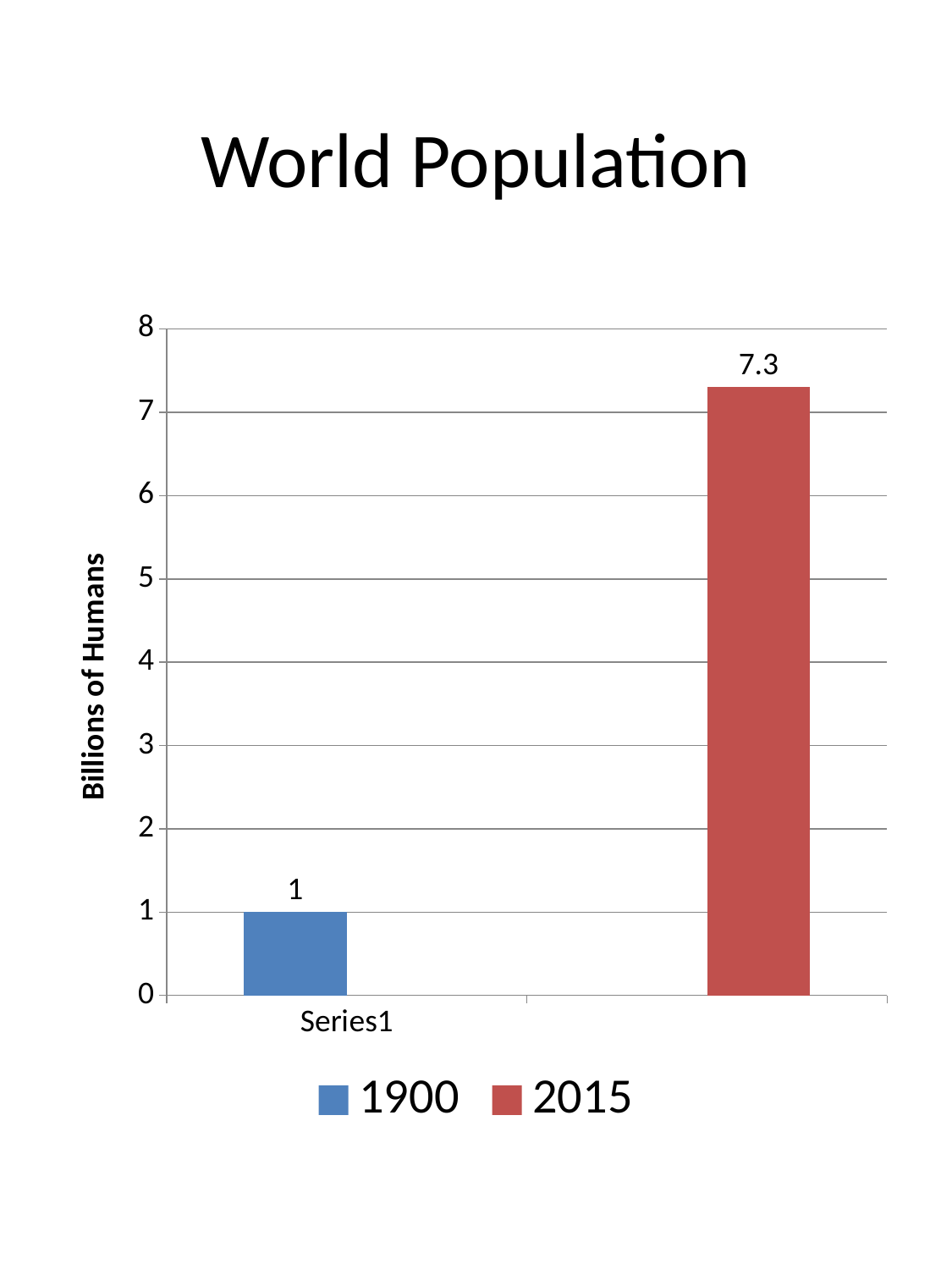
What kind of chart is shown on the slide? bar chart Which series has the lowest value in the World Population chart? 1900 What is the value for 2015 in the World Population chart? 7.3 What is the value for 1900 in the World Population chart? 1 Which series has the highest value in the World Population chart? 2015 Is the value for 2015 greater or less than 7? greater What is the title of the chart? World Population What is the difference between the 2015 and 1900 values in the World Population chart? 6.3 What is the label on the vertical axis of the chart? Billions of Humans Which is larger in the World Population chart, the value for 1900 or the value for 2015? 2015 How many series does the legend list in the World Population chart? 2 What is the category label shown on the horizontal axis? Series1